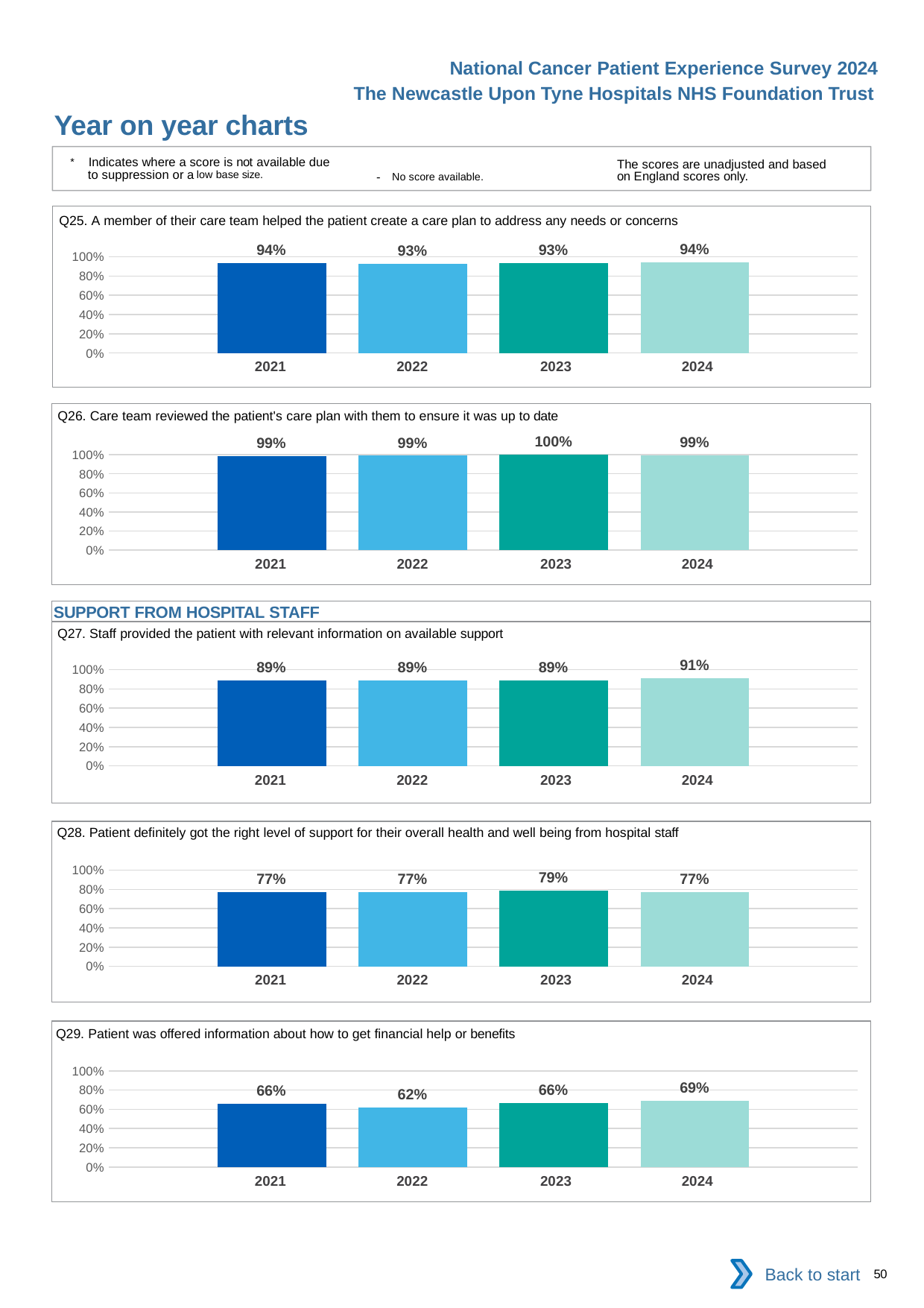
How many years are shown in the Q25 chart? 4 What kind of chart is the Q26 chart? bar chart In the Q29 chart, is the value for 2024 larger or smaller than the value for 2021? larger In the Q27 chart, what is the difference between the 2024 value and the 2023 value? 2% In the Q28 chart, which year has the highest value? 2023 In the Q28 chart, what is the value for 2022? 77% In the Q27 chart, what is the value for 2024? 91% In the Q29 chart, what is the difference between the 2024 value and the 2022 value? 7% In the Q26 chart, which year has the highest value? 2023 In the Q25 chart, what is the value for 2021? 94% In the Q26 chart, what is the value for 2023? 100% In the Q29 chart, which year has the lowest value? 2022